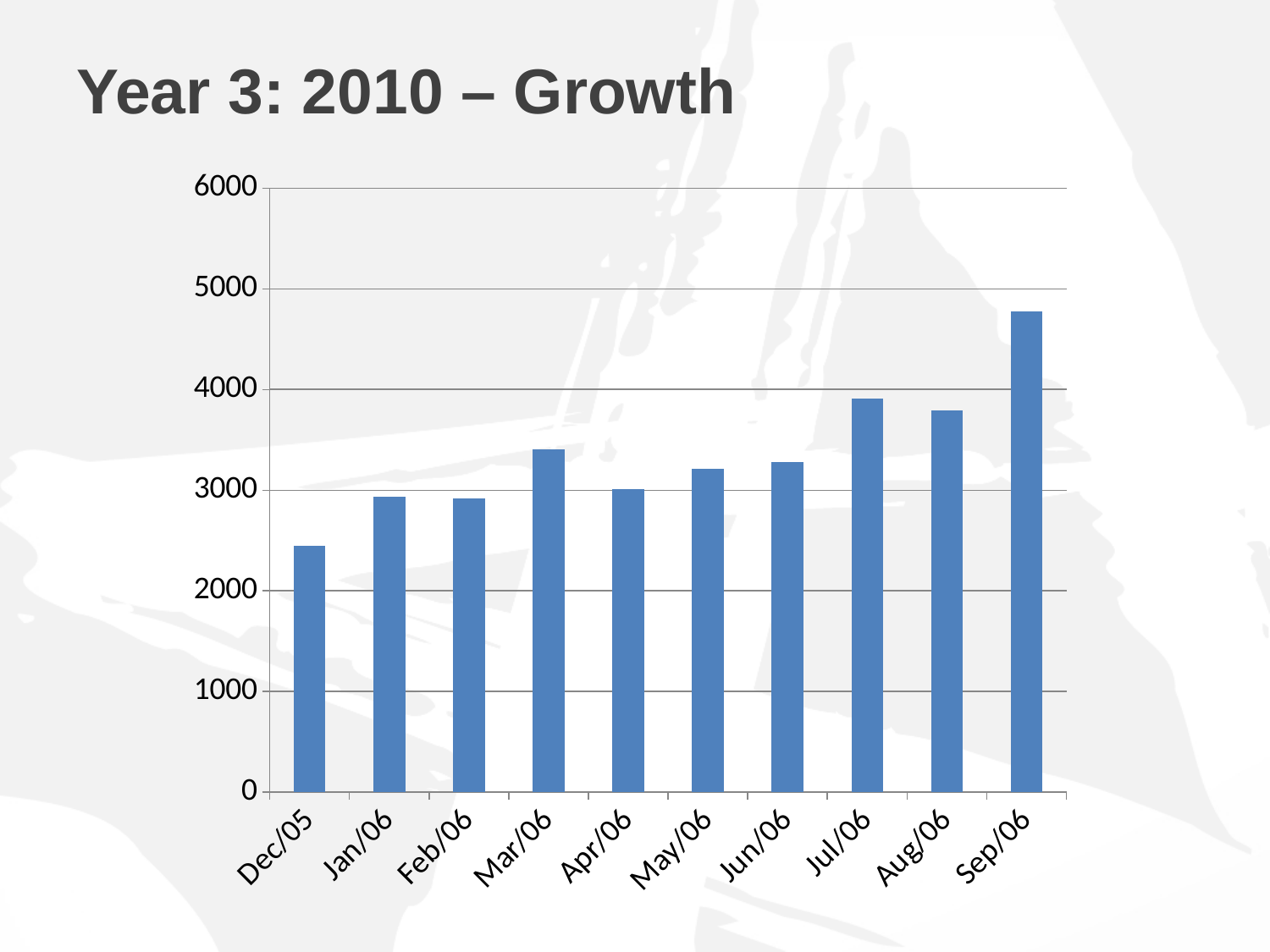
Is the value for Jun/06 greater or less than 3000? greater Do the values generally rise or fall from Dec/05 to Sep/06? rise What kind of chart is shown on the slide? bar chart How many months are plotted on the x axis of the chart? 10 Is the value for Aug/06 greater or less than 4000? less Which month has the lowest bar in the chart? Dec/05 Is the value for Sep/06 greater or less than 5000? less What is the title of the slide containing the chart? Year 3: 2010 – Growth Which is larger, the value for Jul/06 or the value for Sep/06? Sep/06 Which month has the highest bar in the chart? Sep/06 Which is larger, the value for Mar/06 or the value for Apr/06? Mar/06